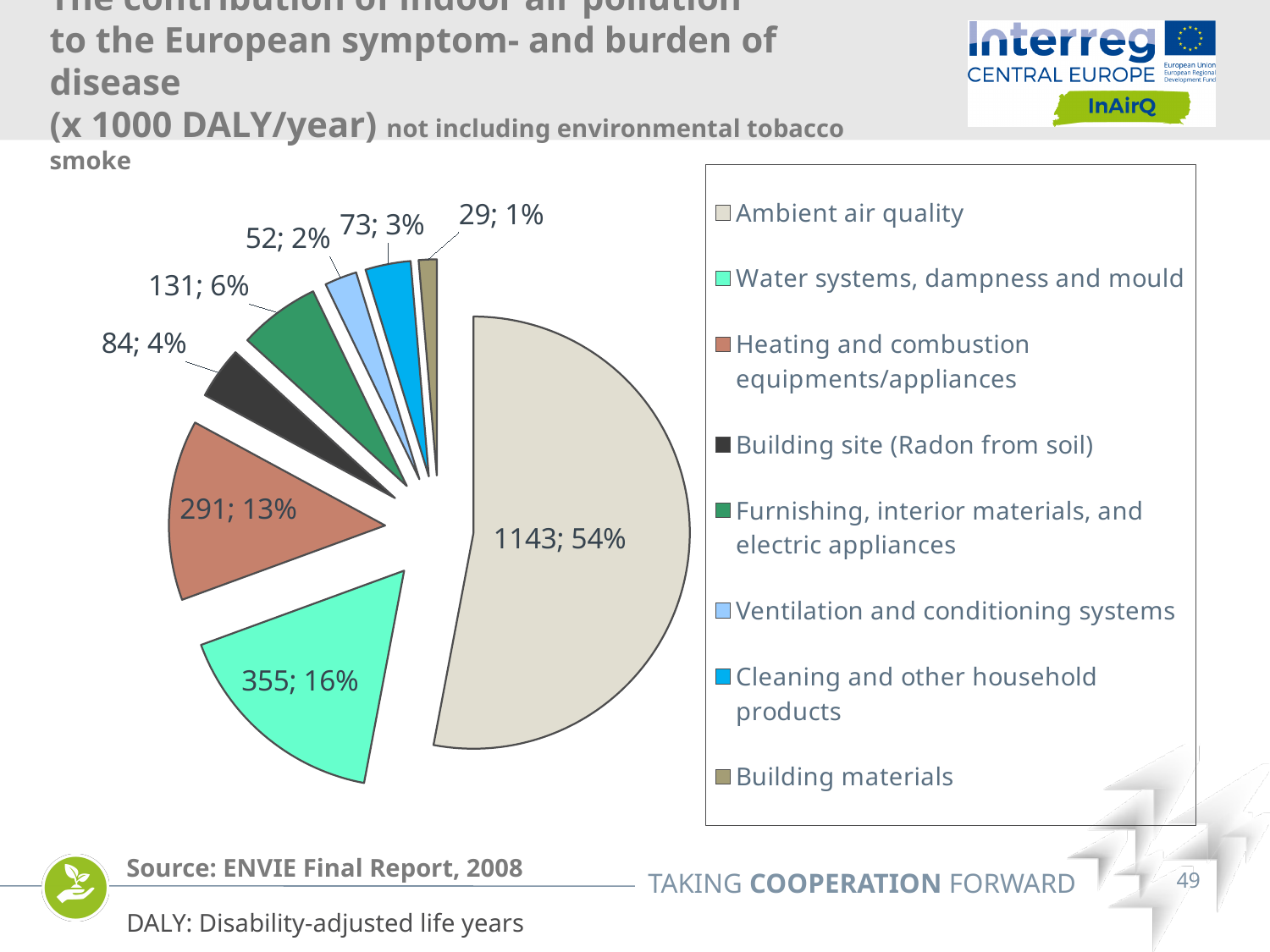
What value is shown for Building site (Radon from soil)? 84; 4% What value is shown for Ambient air quality? 1143; 54% How many entries does the legend list? 8 How many slices does the pie chart have? 8 What kind of chart is shown on the slide? pie chart What share of the pie does Furnishing, interior materials, and electric appliances account for? 6% What value is shown for Water systems, dampness and mould? 355; 16% Which is larger, the value for Cleaning and other household products or the value for Ventilation and conditioning systems? Cleaning and other household products Which category has the largest slice of the pie? Ambient air quality What is the difference between the values for Water systems, dampness and mould and Heating and combustion equipments/appliances? 64 What value is shown for Heating and combustion equipments/appliances? 291; 13% Which category has the smallest slice of the pie? Building materials